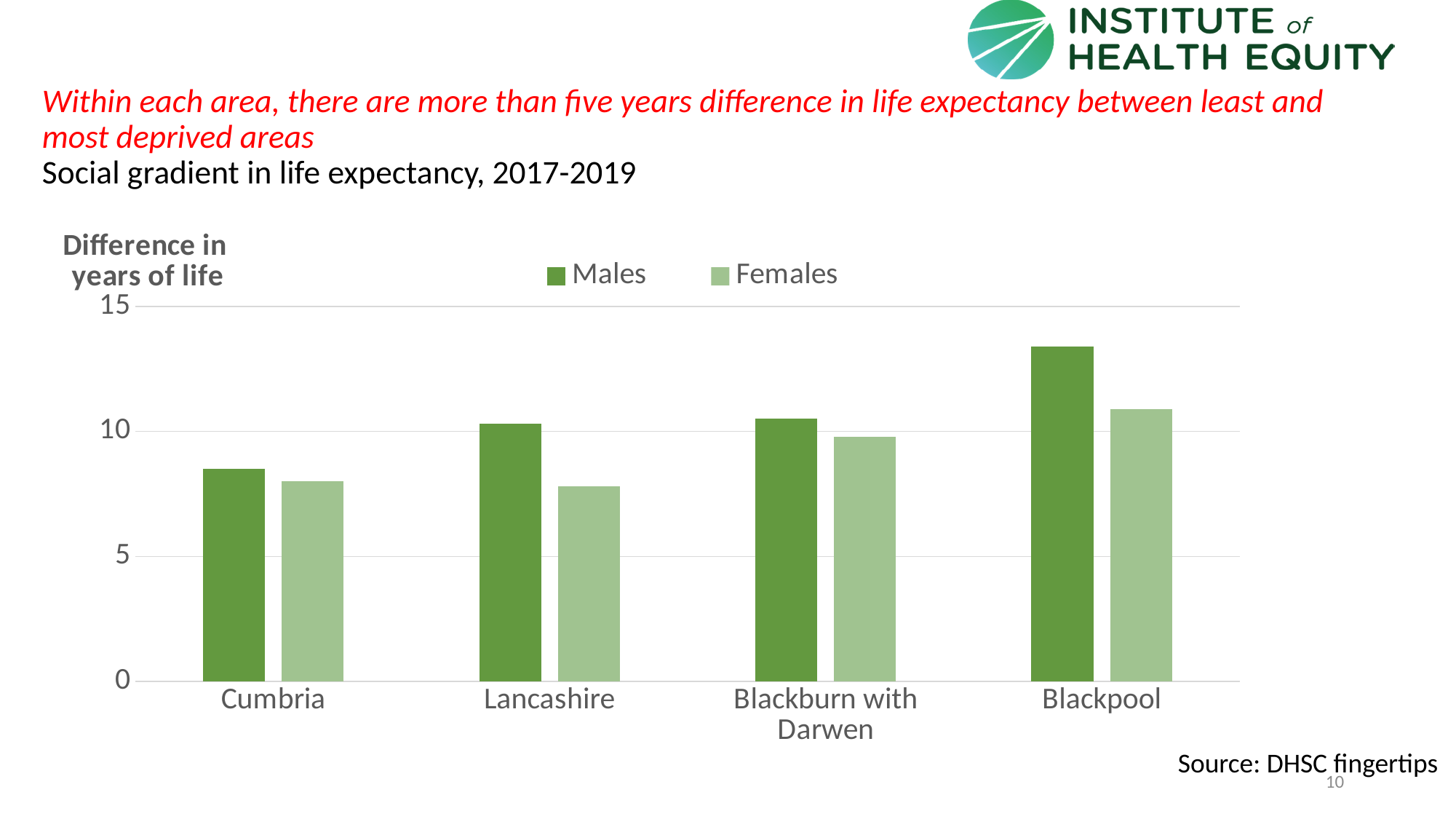
Do the values for Males rise or fall moving from Cumbria to Blackpool along the x axis? rise Is the value for Males in Blackpool greater or less than 10? greater Is the value for Males in Cumbria greater or less than 10? less Which is larger in Lancashire, the value for Males or the value for Females? Males Which area has the lowest value for Males? Cumbria How many series does the legend list? 2 What is the label on the vertical axis of the chart? Difference in years of life Which area has the highest value for Females? Blackpool How many areas are shown on the x axis? 4 What kind of chart is shown on the slide? bar chart Which area has the highest value for Males? Blackpool Is the value for Females in Lancashire greater or less than 10? less